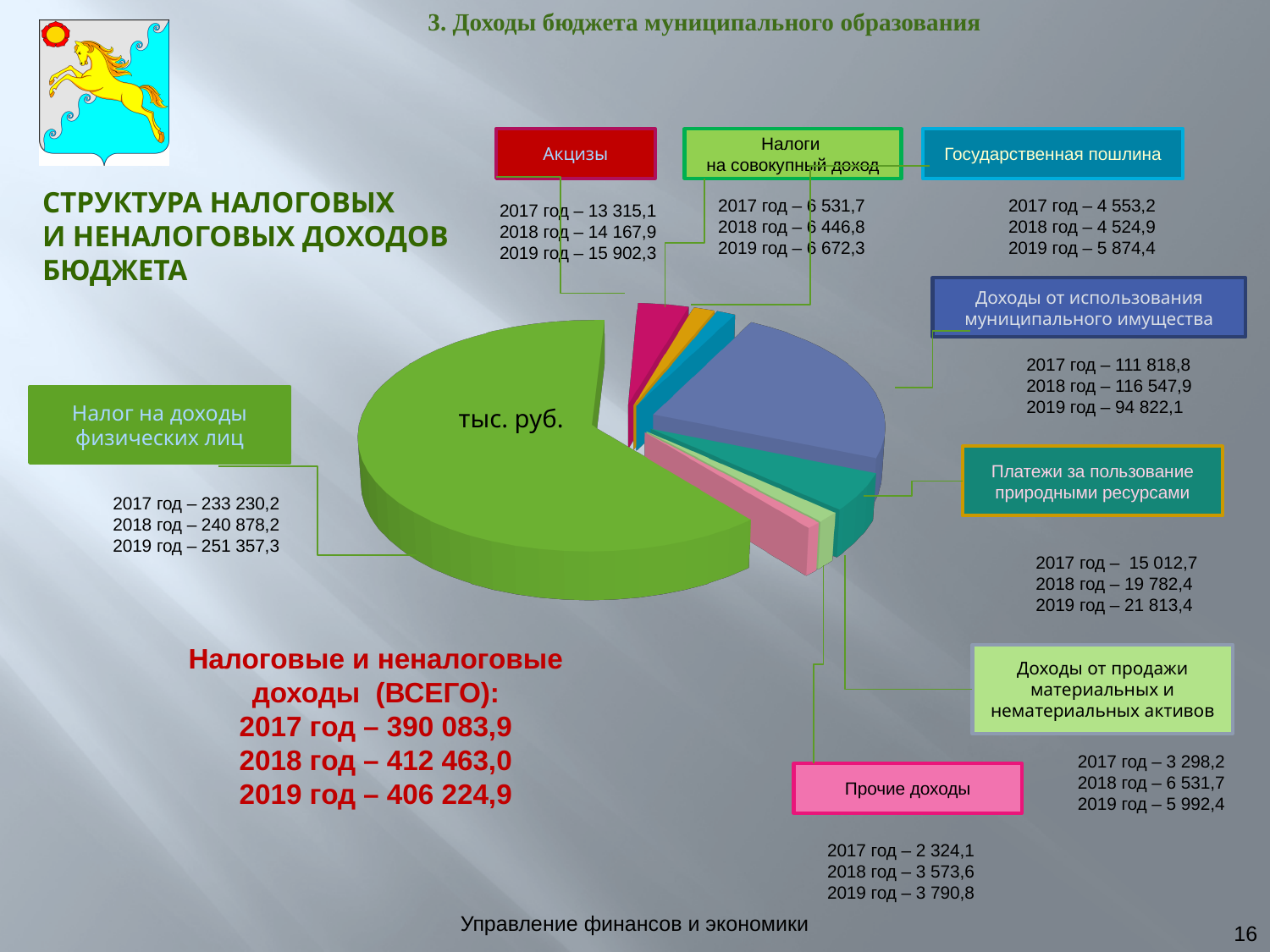
What is the value of 'Акцизы' for 2017? 13 315,1 Do the values of 'Налог на доходы физических лиц' rise or fall from 2017 to 2019? rise Which category has the largest value in 2019? Налог на доходы физических лиц What is the value of 'Налог на доходы физических лиц' for 2019? 251 357,3 What kind of chart is shown on the slide? pie chart How many revenue categories are labelled around the pie chart? 8 What is the difference between the 2019 and 2018 values of 'Налог на доходы физических лиц'? 10 479,1 What is the total of 'Налоговые и неналоговые доходы (ВСЕГО)' for 2019? 406 224,9 What is the value of 'Доходы от использования муниципального имущества' for 2018? 116 547,9 Which is larger in 2019: 'Акцизы' or 'Платежи за пользование природными ресурсами'? Платежи за пользование природными ресурсами Which category has the smallest value in 2019? Прочие доходы What unit is printed on the pie chart? тыс. руб.